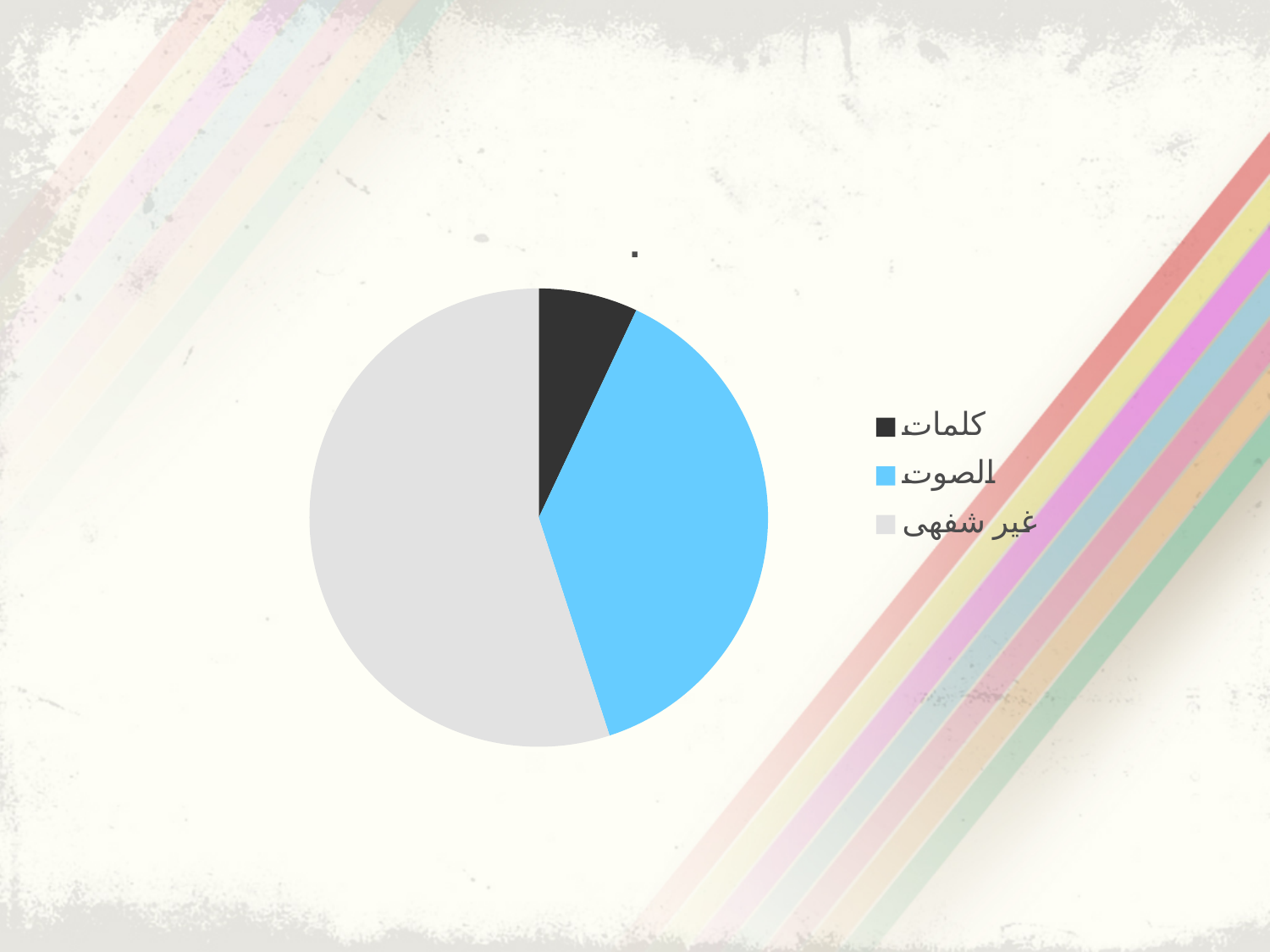
Which category has the largest slice of the pie? غير شفهى What colour is the slice for الصوت? blue How many slices does the pie chart have? 3 Which slice is larger, غير شفهي or الصوت? غير شفهى What colour is the slice for كلمات? black How many entries does the legend list? 3 Which slice is larger, الصوت or كلمات? الصوت What kind of chart is shown on the slide? pie chart Which category has the smallest slice of the pie? كلمات